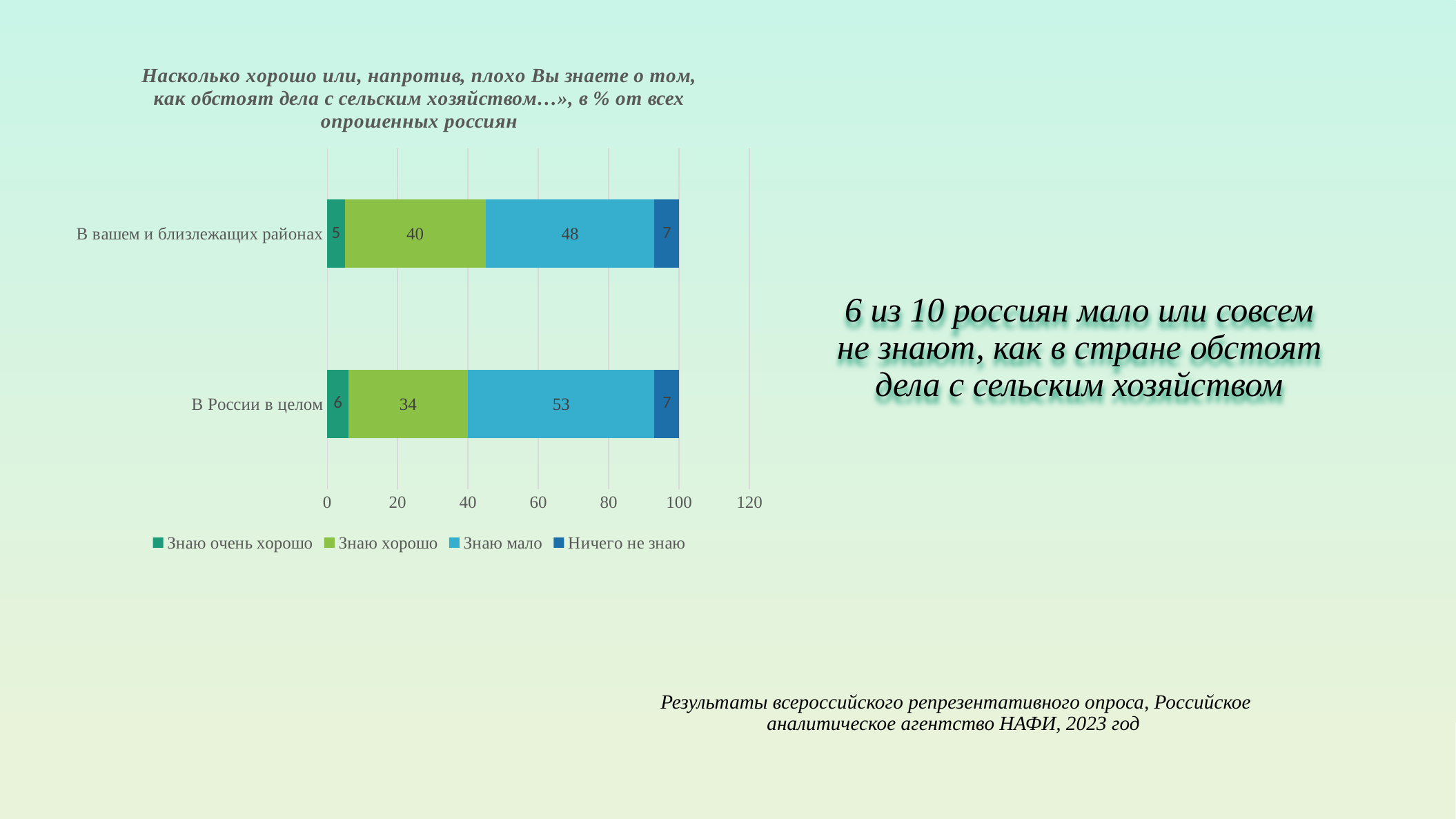
Which series has the largest value in the "В вашем и близлежащих районах" bar? Знаю мало What type of chart is shown on the slide? Stacked bar chart What is the last entry in the chart legend? Ничего не знаю What is the value of "Знаю очень хорошо" for "В России в целом"? 6 What is the difference between the "Знаю мало" values for "В России в целом" and "В вашем и близлежащих районах"? 5 What is the total of the stacked bar for "В России в целом"? 100 How many categories are shown on the chart? 2 What is the value of "Знаю хорошо" for "В вашем и близлежащих районах"? 40 How many series does the legend list? 4 What is the value of "Ничего не знаю" for "В вашем и близлежащих районах"? 7 Which category has the higher value for "Знаю хорошо"? В вашем и близлежащих районах What is the value of "Знаю мало" for "В России в целом"? 53